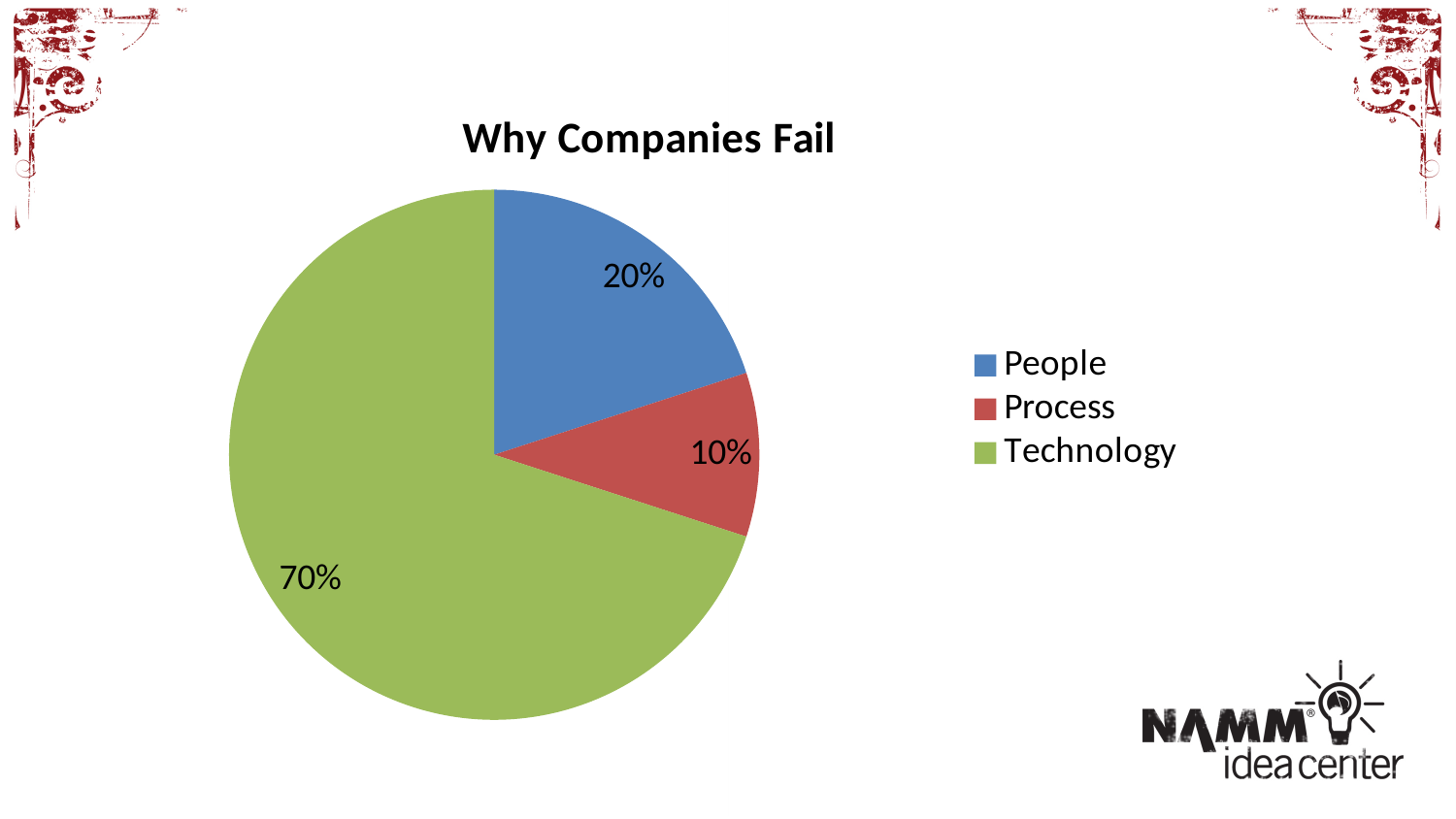
What colour is the Technology slice? green Which category has the largest share of the pie? Technology How many categories does the legend list? 3 Which is larger, the People slice or the Process slice? People Which category has the smallest share of the pie? Process What kind of chart is shown on the slide? pie chart What percentage does the Process slice represent? 10% What percentage does the People slice represent? 20% What is the title of the chart? Why Companies Fail What is the difference in percentage points between the Technology and People slices? 50 What is the combined share of the People and Process slices? 30% What percentage does the Technology slice represent? 70%